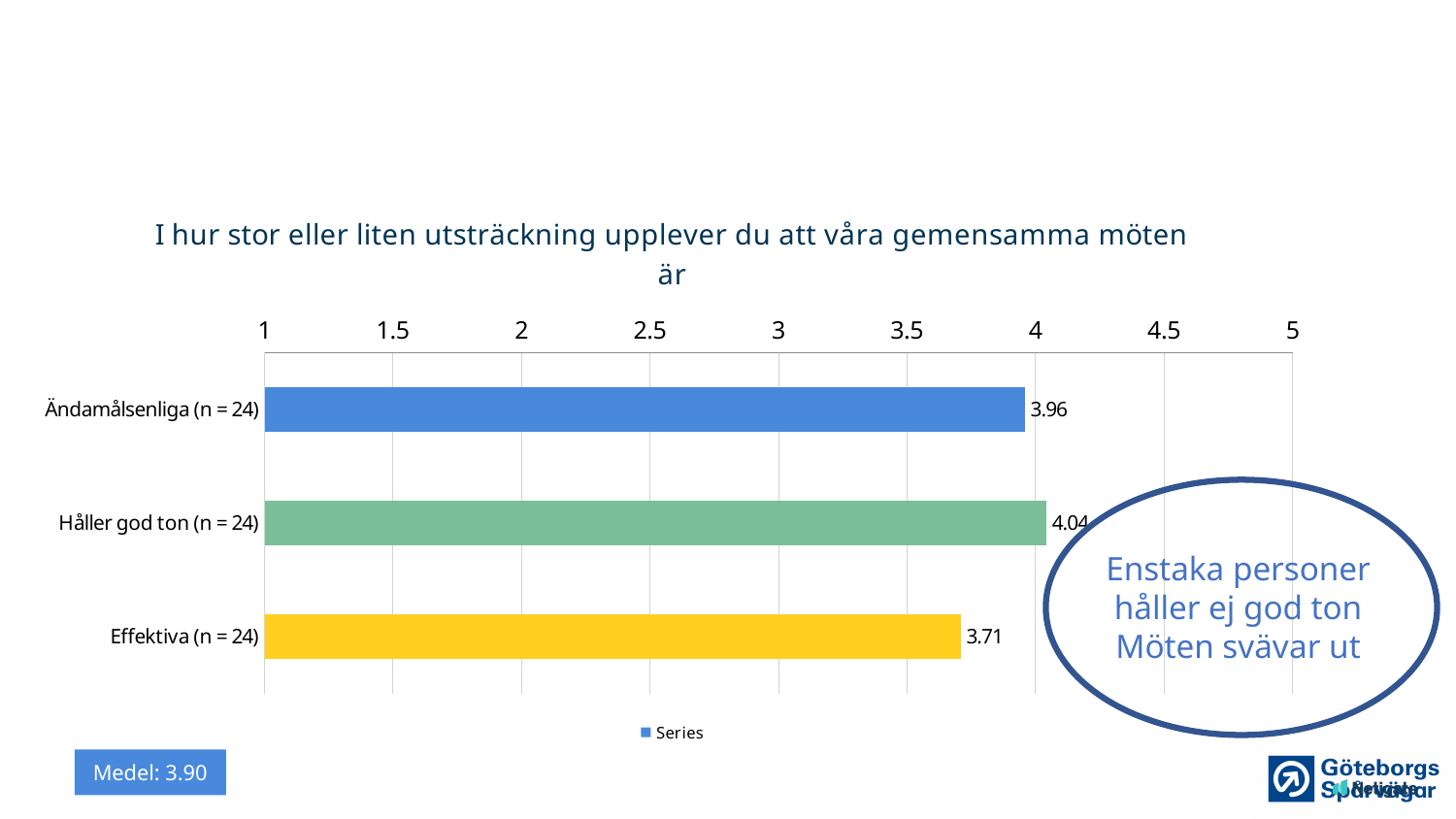
Is the value for Effektiva (n = 24) greater or less than 4? less How many categories are shown in the chart? 3 What is the value for Håller god ton (n = 24)? 4.04 What is the value for Effektiva (n = 24)? 3.71 What is the difference between the values for Ändamålsenliga (n = 24) and Effektiva (n = 24)? 0.25 What kind of chart is shown on the slide? bar chart Which is larger, the value for Ändamålsenliga (n = 24) or the value for Effektiva (n = 24)? Ändamålsenliga (n = 24) Which category has the lowest value? Effektiva (n = 24) Which category has the highest value? Håller god ton (n = 24) What is the title of the chart? I hur stor eller liten utsträckning upplever du att våra gemensamma möten är What is the difference between the values for Håller god ton (n = 24) and Effektiva (n = 24)? 0.33 What is the value for Ändamålsenliga (n = 24)? 3.96